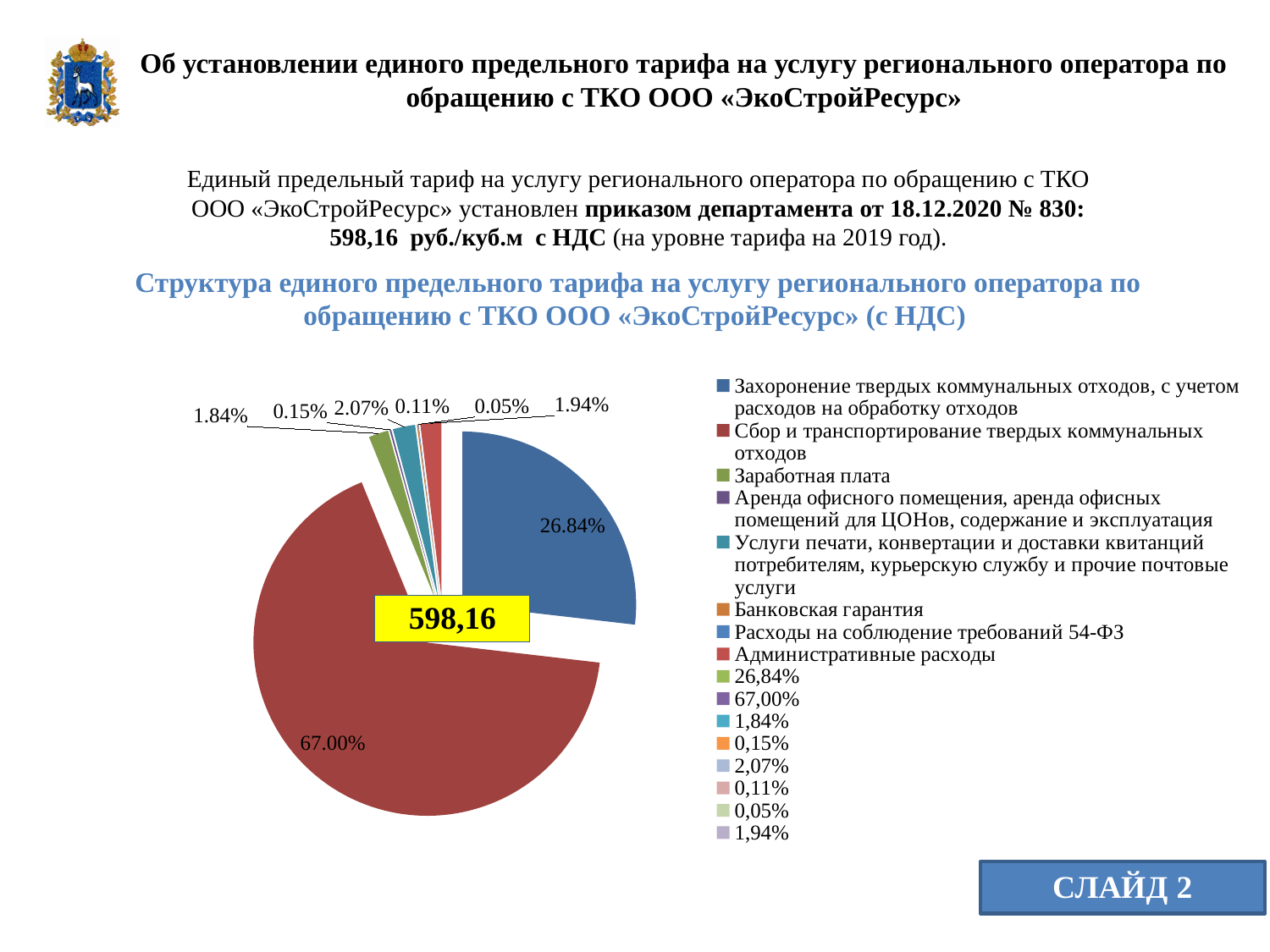
What share of the pie does the slice for "Сбор и транспортирование твердых коммунальных отходов" represent? 67.00% What share of the pie is labelled for "Банковская гарантия"? 0.11% What value is shown in the yellow box in the centre of the pie chart? 598,16 Which is larger: the slice for "Заработная плата" or the slice for "Услуги печати, конвертации и доставки квитанций потребителям, курьерскую службу и прочие почтовые услуги"? Услуги печати, конвертации и доставки квитанций потребителям, курьерскую службу и прочие почтовые услуги Which category has the largest slice of the pie? Сбор и транспортирование твердых коммунальных отходов Which category has the smallest slice of the pie? Расходы на соблюдение требований 54-ФЗ How many slices does the pie chart have? 8 What kind of chart is shown on the slide? pie chart What share of the pie does the slice for "Захоронение твердых коммунальных отходов, с учетом расходов на обработку отходов" represent? 26.84% What is the difference in percentage points between the 67.00% slice and the 26.84% slice? 40.16 What colour is the largest slice of the pie chart? red What share of the pie is labelled for "Административные расходы"? 1.94%